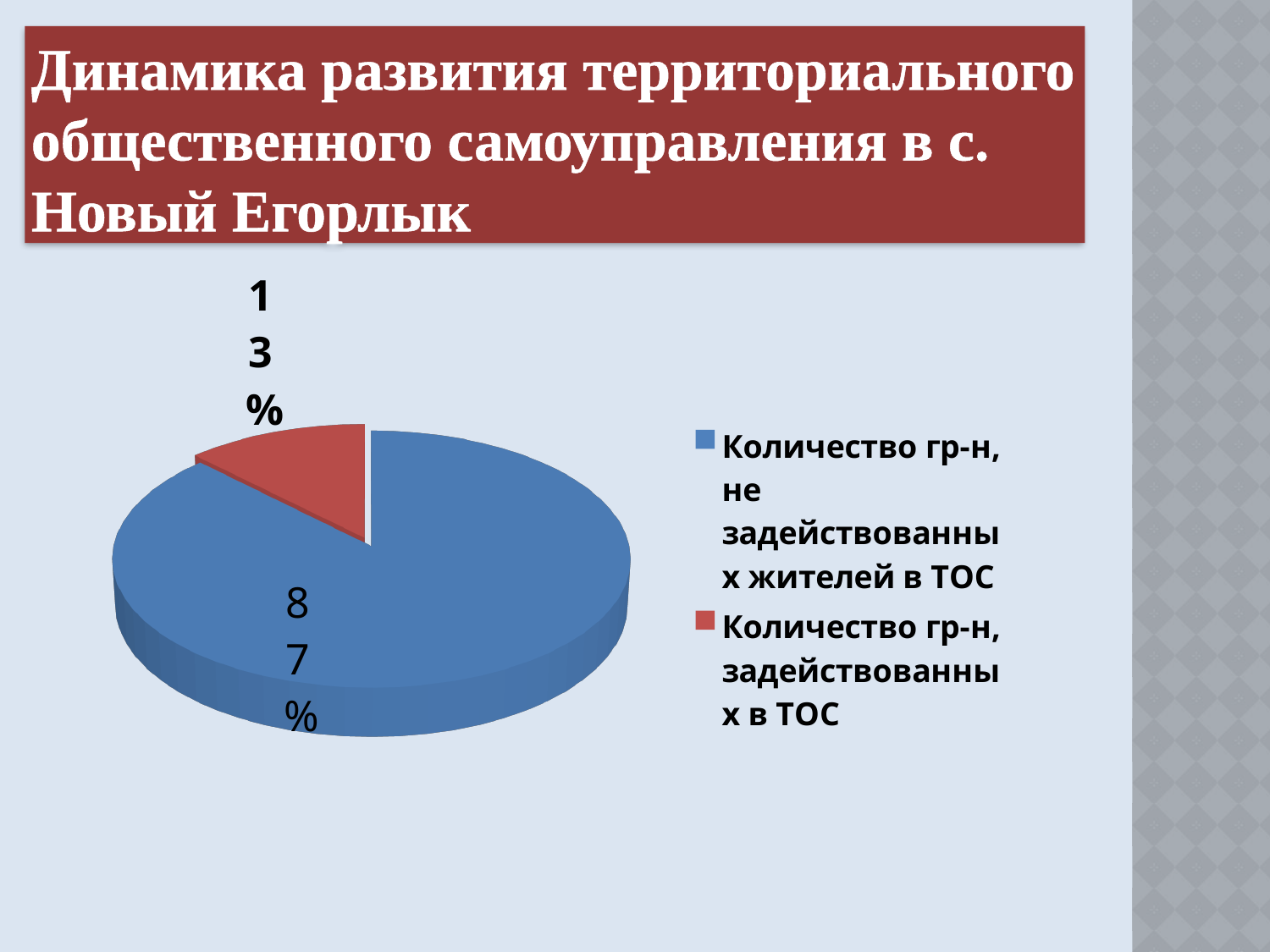
Which is larger: the slice for residents involved in ТОС or the slice for residents not involved in ТОС? residents not involved in ТОС Is the share for "Количество гр-н, задействованных в ТОС" greater or less than 50%? less What share of the pie is labelled for "Количество гр-н, не задействованных жителей в ТОС"? 87% What colour is the slice for "Количество гр-н, задействованных в ТОС"? red How many slices does the pie chart have? 2 What share of the pie is labelled for "Количество гр-н, задействованных в ТОС"? 13% How many entries does the legend list? 2 What is the title of the slide containing the chart? Динамика развития территориального общественного самоуправления в с. Новый Егорлык Which category has the largest slice of the pie? Количество гр-н, не задействованных жителей в ТОС What kind of chart is shown on the slide? pie chart Which category has the smallest slice of the pie? Количество гр-н, задействованных в ТОС What is the difference in percentage points between the two slices of the pie? 74